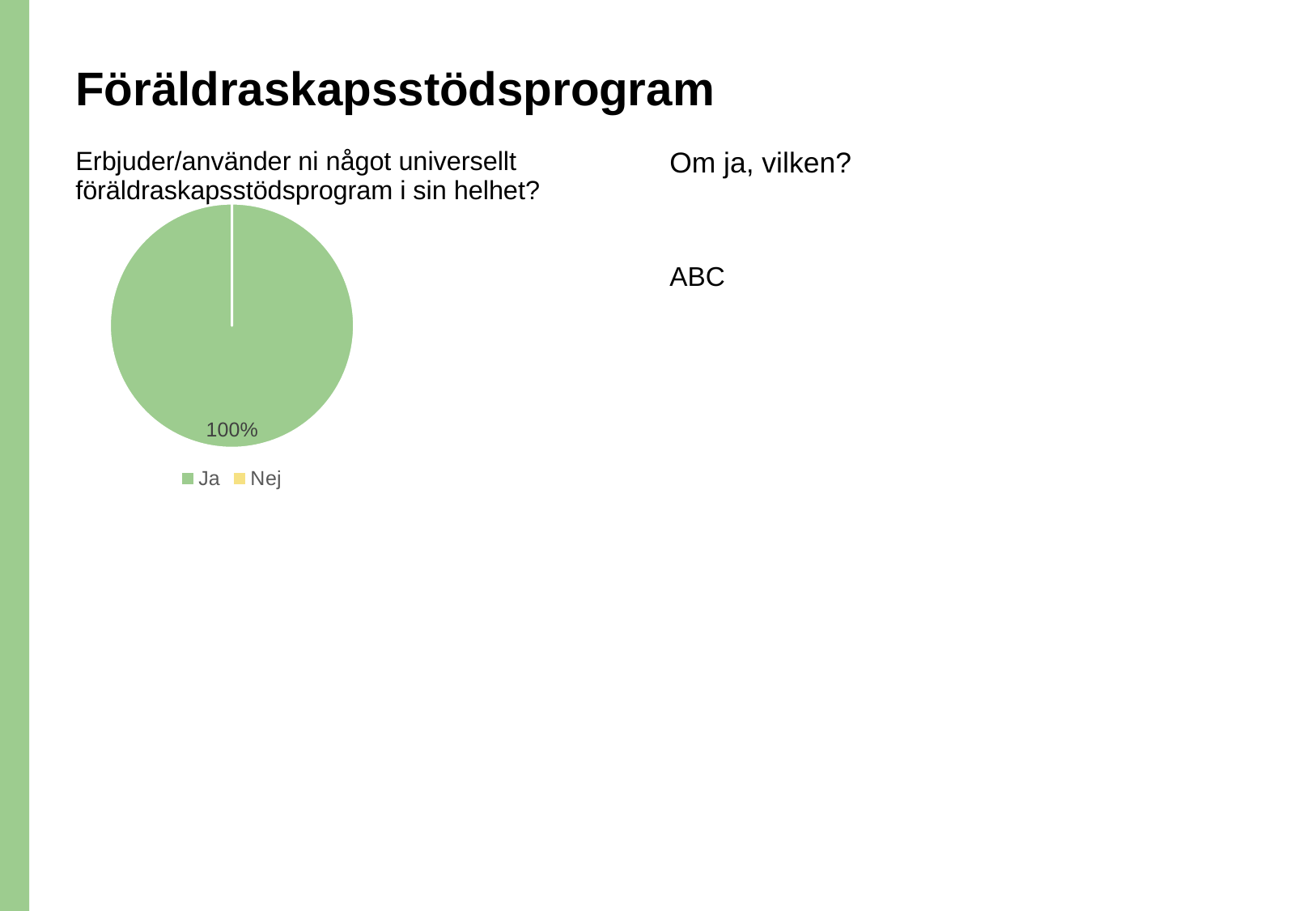
What share of the pie does "Ja" have? 100% What colour is the "Ja" slice of the pie? green What is the only data label printed on the pie chart? 100% What kind of chart is shown on the slide? pie chart Which is larger, the share for "Ja" or the share for "Nej"? Ja Which category has the largest share of the pie? Ja What are the two legend entries of the pie chart? Ja, Nej How many entries does the legend list? 2